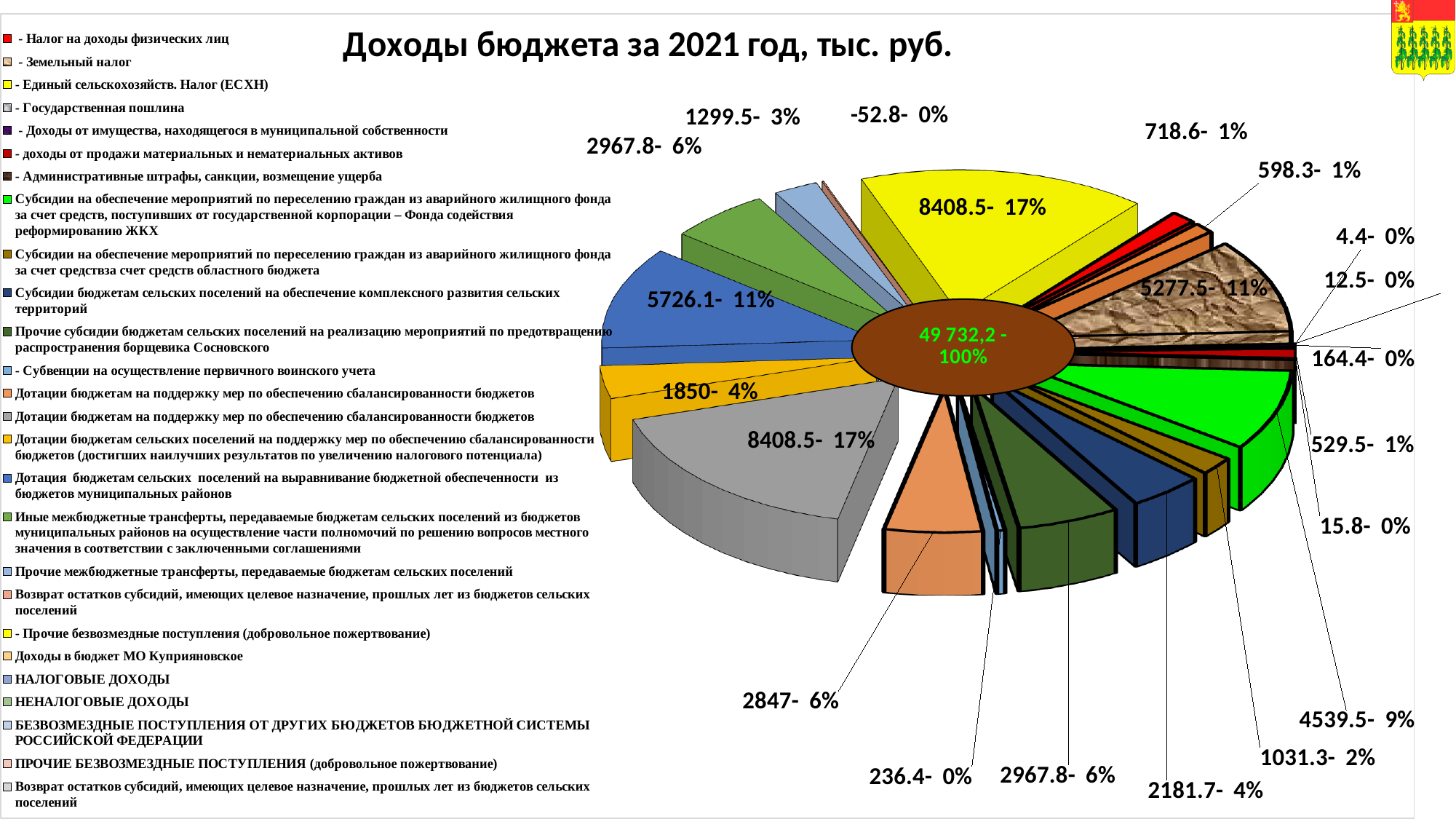
Which is larger, the slice labelled 5726.1 or the slice labelled 4539.5? 5726.1 What is the largest percentage share shown on any slice label? 17% What total value is printed in the centre of the pie chart? 49 732,2 What percentage share is shown for the slice labelled 4539.5? 9% What percentage share is shown for the slice labelled 2847? 6% What percentage share is shown for the slice labelled 5277.5? 11% What is the difference between the slice labelled 8408.5 and the slice labelled 5726.1? 2682.4 What kind of chart is shown on the slide? pie chart How many entries does the legend on the left list? 26 What is the smallest value printed on a slice label? -52.8 What value is printed on the slice whose share is 2%? 1031.3 What is the title of the chart? Доходы бюджета за 2021 год, тыс. руб.